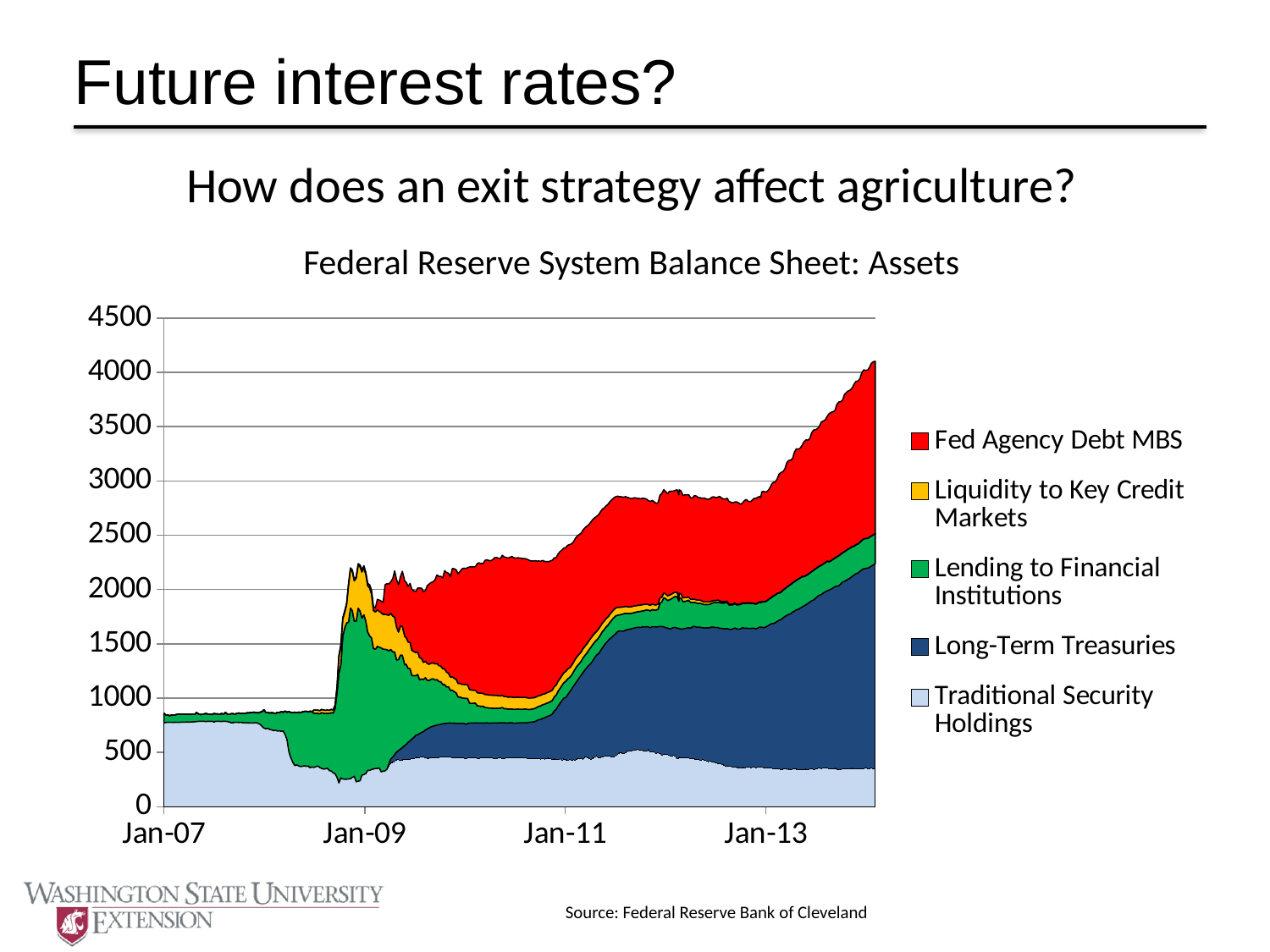
Is the total of all assets at Jan-11 greater or less than 2000? greater What is the highest value shown on the vertical axis? 4500 Is the total of all assets at Jan-13 greater or less than the total at Jan-11? greater Which series is shown in red in the chart? Fed Agency Debt MBS What kind of chart is shown on the slide? Stacked area chart How many series does the chart's legend list? 5 Is the total of all assets at the right end of the chart greater or less than 3500? greater What is the title of the chart? Federal Reserve System Balance Sheet: Assets Does the total of all assets rise or fall between Jan-07 and the end of the chart? rise Is the total of all assets at Jan-13 greater or less than 2500? greater